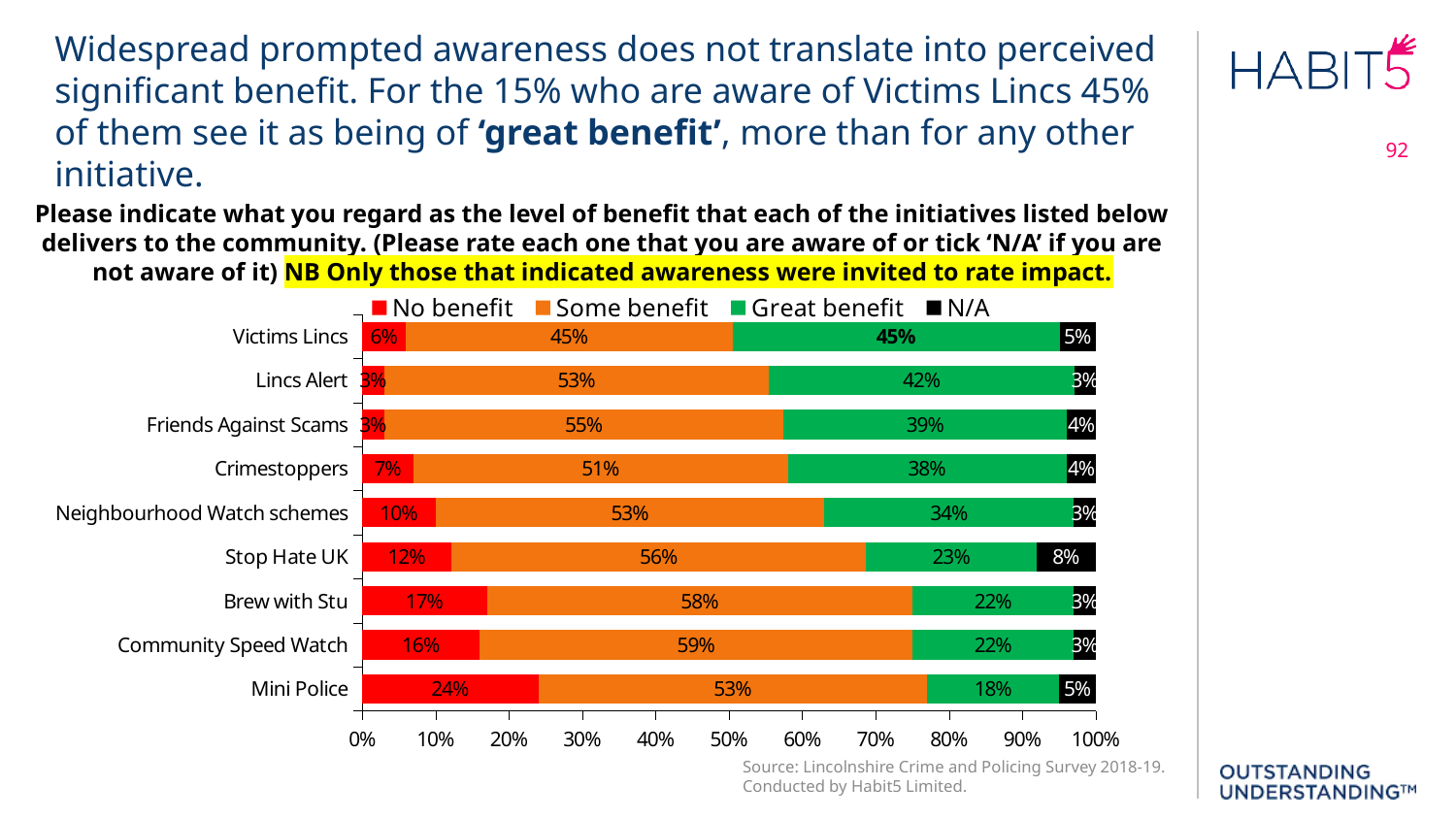
Which initiative has the highest 'No benefit' percentage? Mini Police What type of chart is shown on the slide? Stacked bar chart What is the 'No benefit' value for Mini Police? 24% Which initiative has the lowest 'Great benefit' percentage? Mini Police Which initiative has the highest 'Great benefit' percentage? Victims Lincs What percentage of respondents rated Victims Lincs as 'Great benefit'? 45% Which has a larger 'Some benefit' value, Brew with Stu or Crimestoppers? Brew with Stu What is the 'N/A' value for Stop Hate UK? 8% What is the difference between the 'Great benefit' values for Victims Lincs and Mini Police? 27 percentage points How many initiatives are shown in the chart? 9 What is the 'Some benefit' value for Community Speed Watch? 59% How many series does the legend list? 4